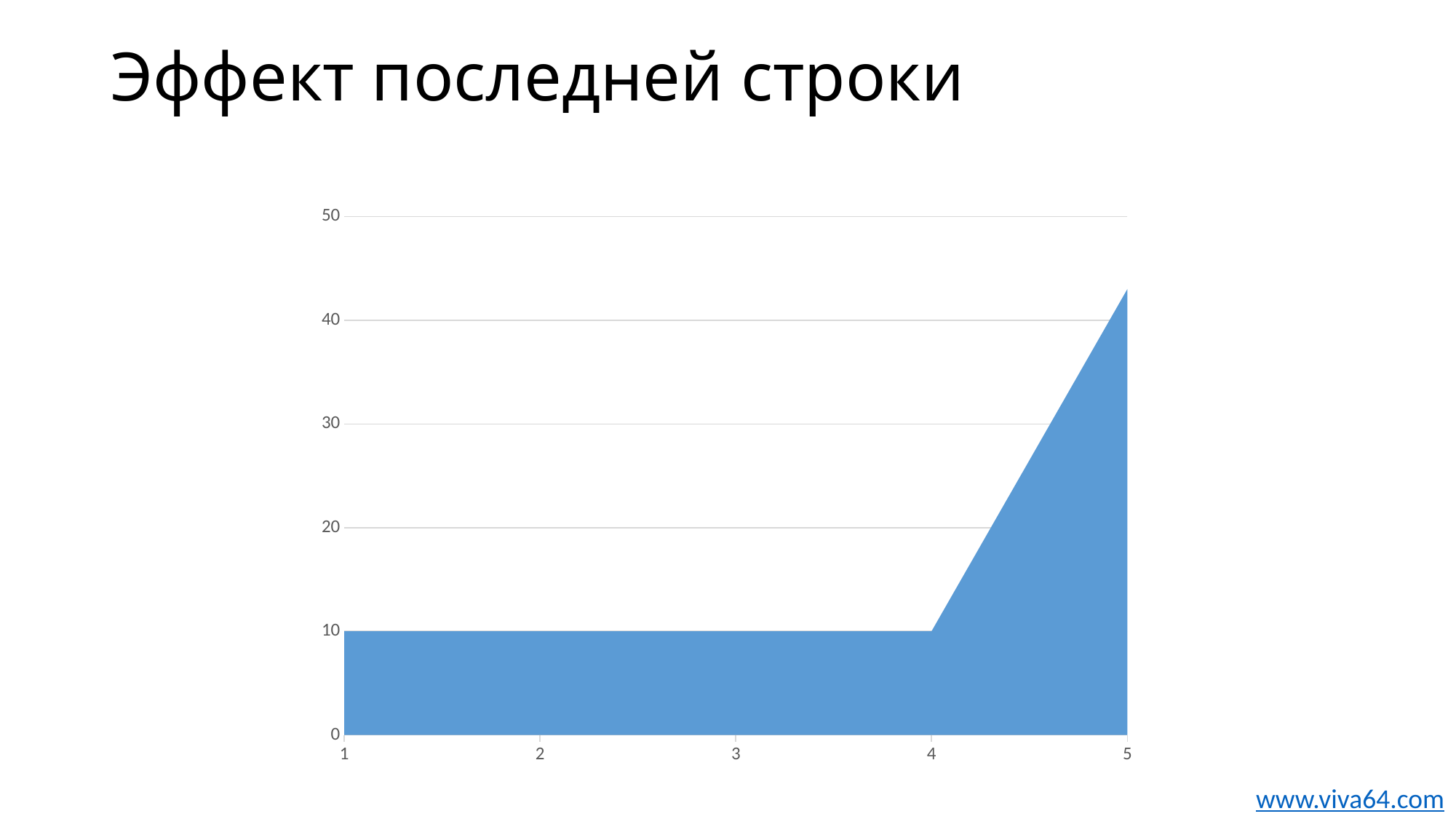
What is the value at x = 1? 10 At which x value is the plotted value highest? 5 What is the title of the slide? Эффект последней строки Do the values rise or fall between x = 4 and x = 5? rise Is the value at x = 3 greater or less than 20? less Is the value at x = 5 greater or less than 40? greater Is the value at x = 5 greater or less than 50? less How many points are plotted along the x axis? 5 Do the values rise, fall or stay flat between x = 1 and x = 4? stay flat Which is larger, the value at x = 2 or the value at x = 5? x = 5 What kind of chart is shown on the slide? area chart What is the value at x = 4? 10